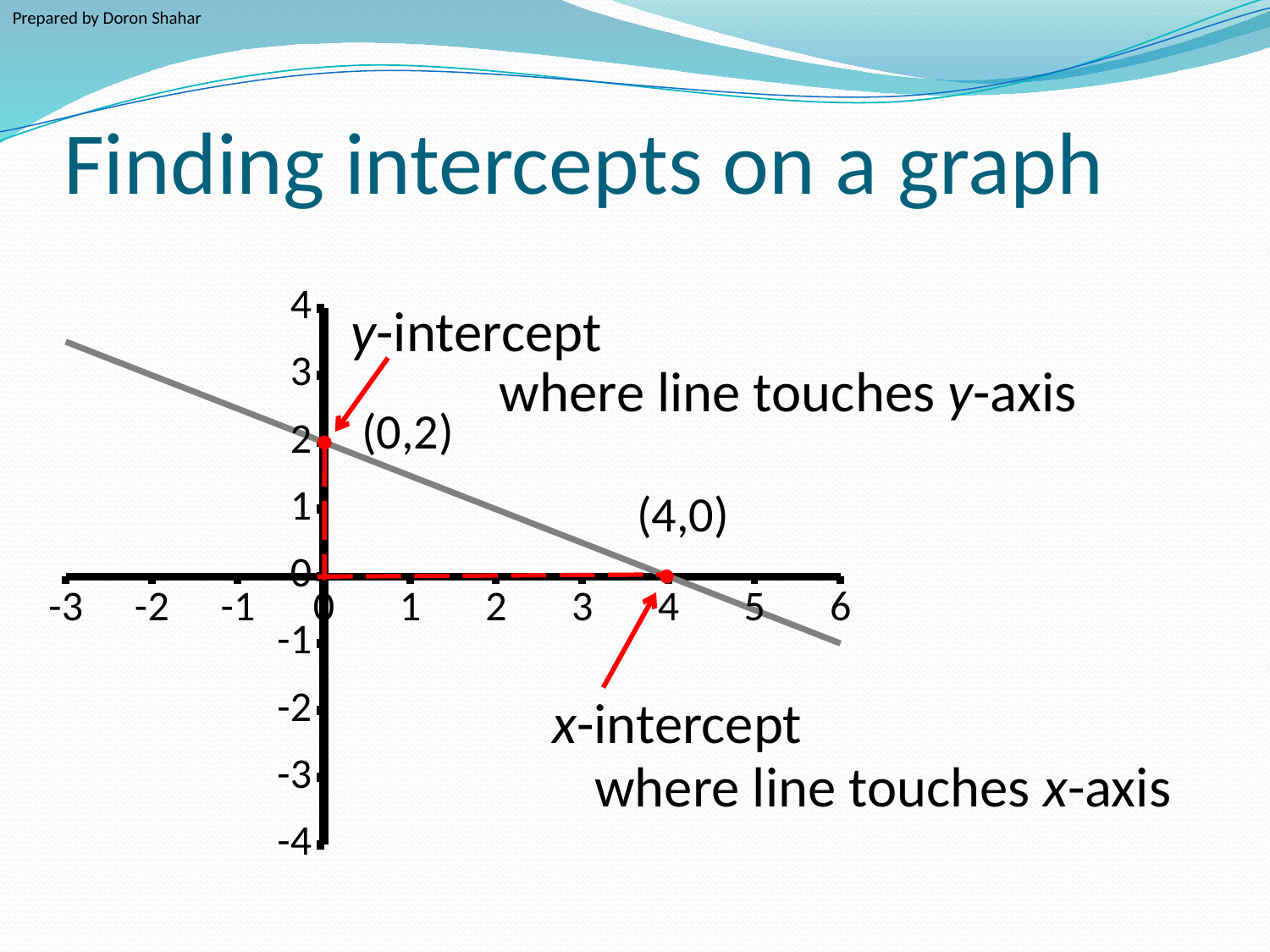
What are the coordinates of the x-intercept labeled on the graph? (4,0) What is the lowest value shown on the x-axis? -3 How many intercept points are marked on the line? 2 Which labeled point has the larger x-value, (0,2) or (4,0)? (4,0) Which labeled point has the larger y-value, (0,2) or (4,0)? (0,2) What are the coordinates of the y-intercept labeled on the graph? (0,2) At x = -2, is the line's y-value greater or less than 2? greater Does the plotted line rise or fall as x increases? fall What kind of chart is shown on the slide? line chart What is the difference between the x-value of the x-intercept and the y-value of the y-intercept? 2 What is the title of the slide containing the graph? Finding intercepts on a graph At x = 6, is the line's y-value greater or less than 0? less